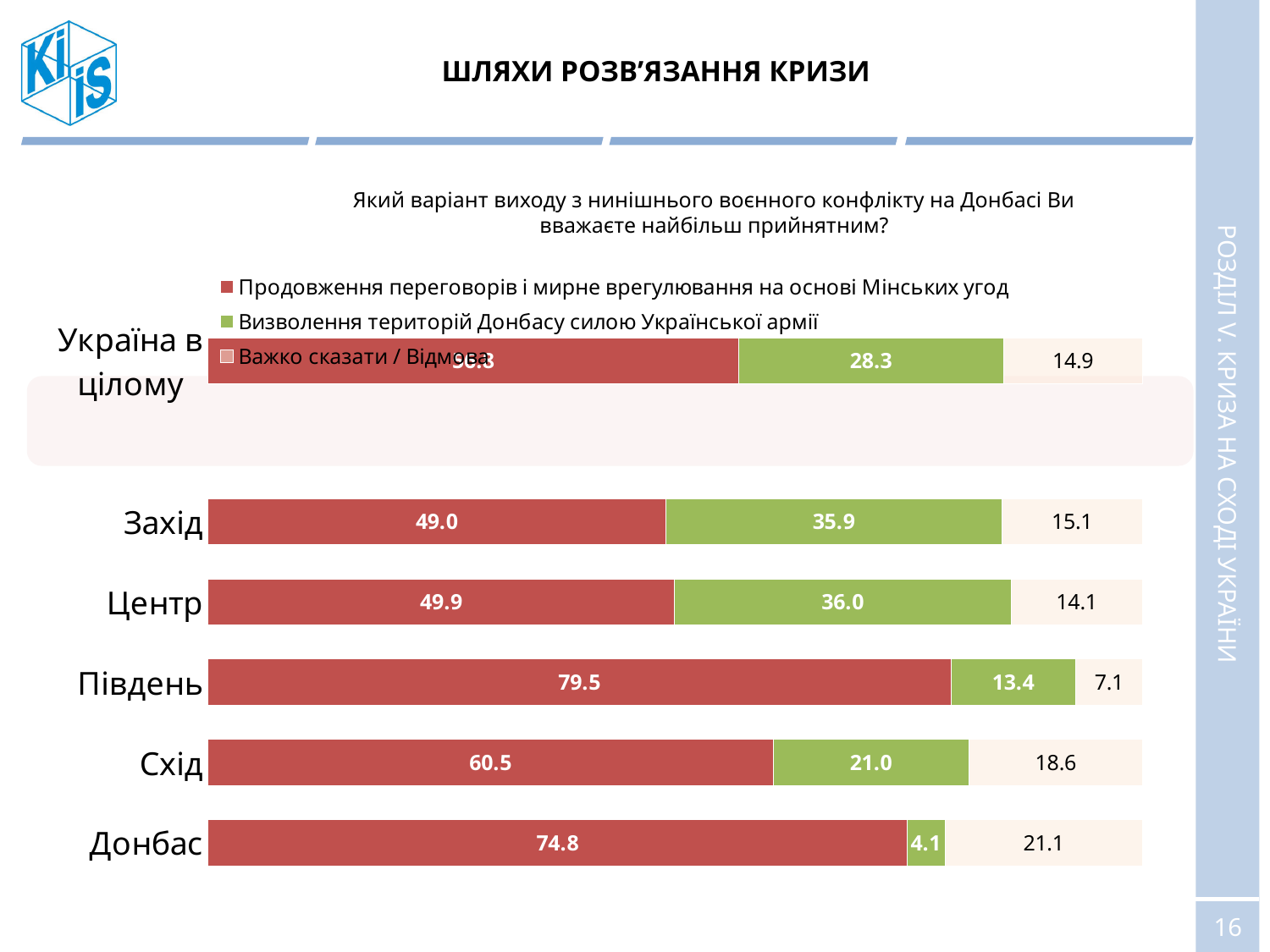
What is the value for 'Важко сказати / Відмова' for Схід? 18.6 How many regional categories are plotted on the chart? 6 How many series does the legend list? 3 Which is larger: the 'Визволення територій Донбасу силою Української армії' value for Схід or for Південь? Схід What type of chart is shown on the slide? Stacked bar chart Which region has the highest value for 'Важко сказати / Відмова'? Донбас Which region has the lowest value for 'Визволення територій Донбасу силою Української армії'? Донбас What is the value for 'Продовження переговорів і мирне врегулювання на основі Мінських угод' for Південь? 79.5 What is the total of the stacked bar for Захід? 100.0 What is the difference between the 'Продовження переговорів' values for Південь and Схід? 19.0 Which region has the highest value for 'Продовження переговорів і мирне врегулювання на основі Мінських угод'? Південь What is the value for 'Визволення територій Донбасу силою Української армії' for Донбас? 4.1